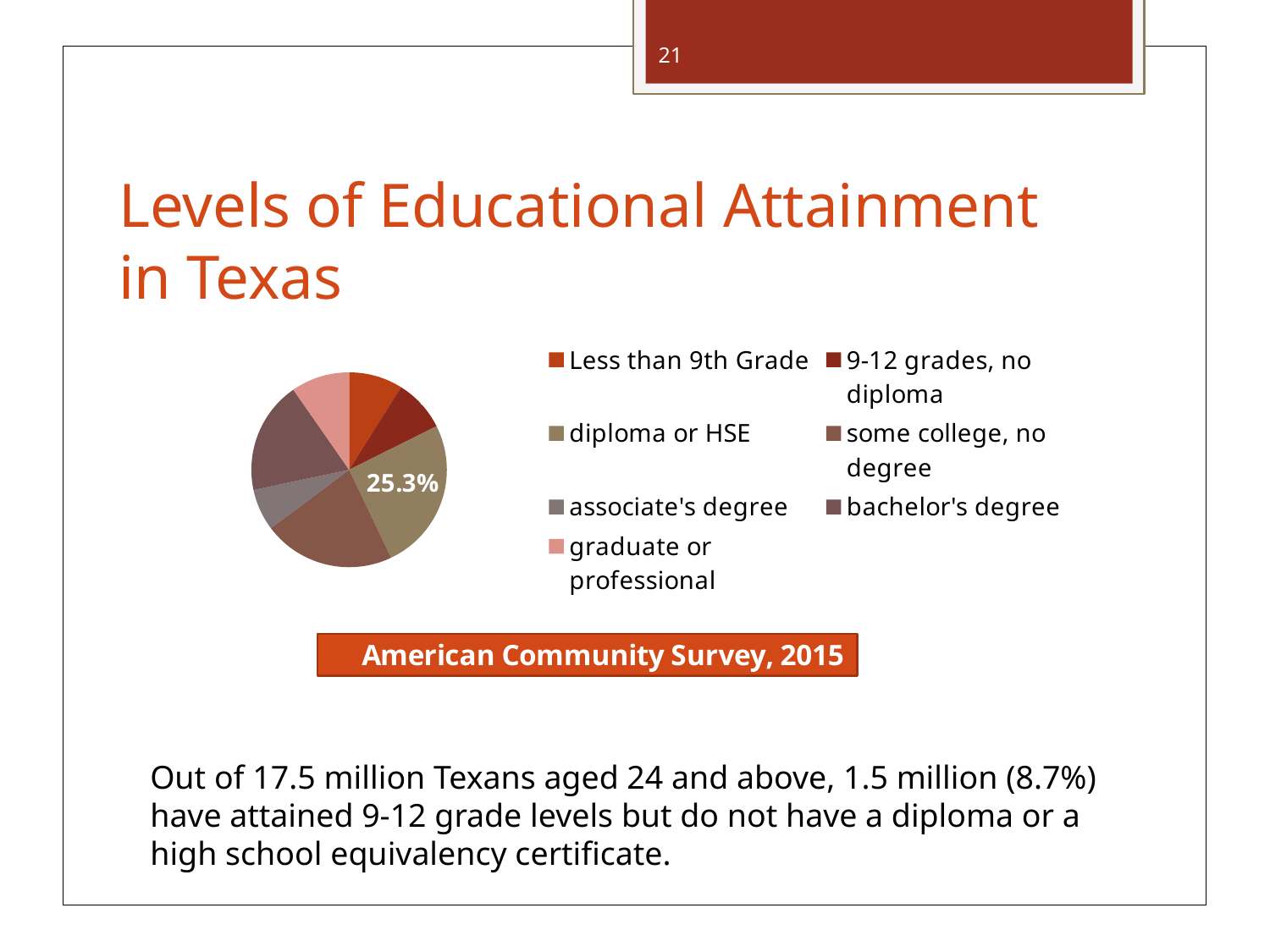
How many entries does the legend of the pie chart list? 7 Which slice is larger in the pie chart: diploma or HSE or associate's degree? diploma or HSE What data source is cited below the pie chart? American Community Survey, 2015 Which category has the largest slice in the pie chart? diploma or HSE What percentage is shown for the diploma or HSE slice of the pie chart? 25.3% Which slice is larger in the pie chart: diploma or HSE or Less than 9th Grade? diploma or HSE How many slices does the pie chart have? 7 Which slice of the pie chart has a data label printed on it? diploma or HSE Which category has the smallest slice in the pie chart? associate's degree What type of chart is shown on the slide? pie chart